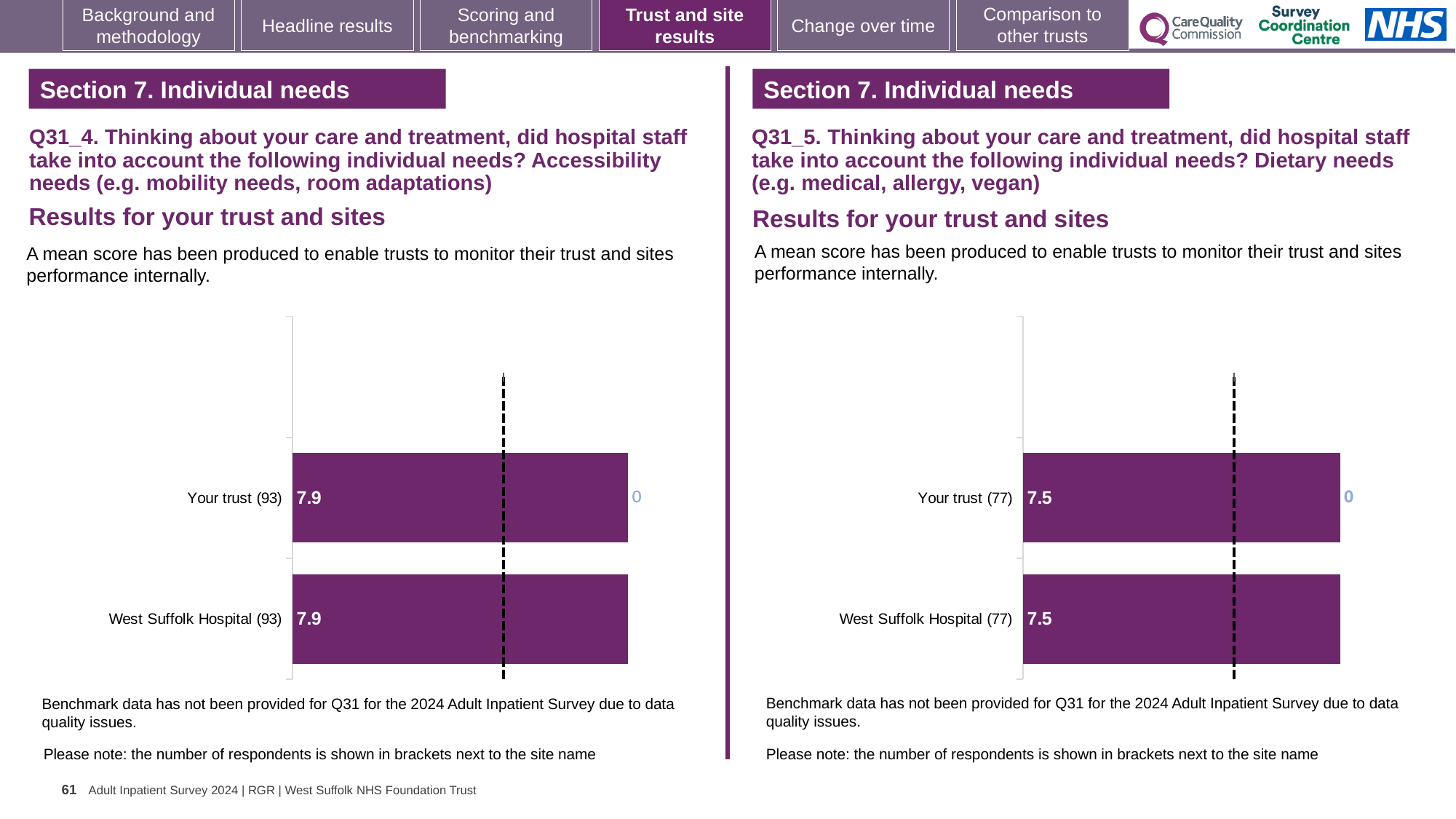
In the left chart (Q31_4, accessibility needs), what is the mean score for West Suffolk Hospital? 7.9 How many bars are plotted in the left chart (Q31_4)? 2 In the right chart (Q31_5), how many respondents are shown in brackets next to Your trust? 77 In the right chart (Q31_5, dietary needs), what is the mean score for West Suffolk Hospital? 7.5 Is the score for Your trust in the left chart (Q31_4) higher or lower than the score for Your trust in the right chart (Q31_5)? Higher In the left chart (Q31_4), what is the difference between the scores for Your trust and West Suffolk Hospital? 0.0 What type of chart is used in the left chart (Q31_4)? Bar chart In the right chart (Q31_5, dietary needs), what is the mean score for Your trust? 7.5 In the right chart (Q31_5), what is the difference between the scores for Your trust and West Suffolk Hospital? 0.0 In the left chart (Q31_4, accessibility needs), what is the mean score for Your trust? 7.9 In the left chart (Q31_4), how many respondents are shown in brackets next to West Suffolk Hospital? 93 How many bars are plotted in the right chart (Q31_5)? 2